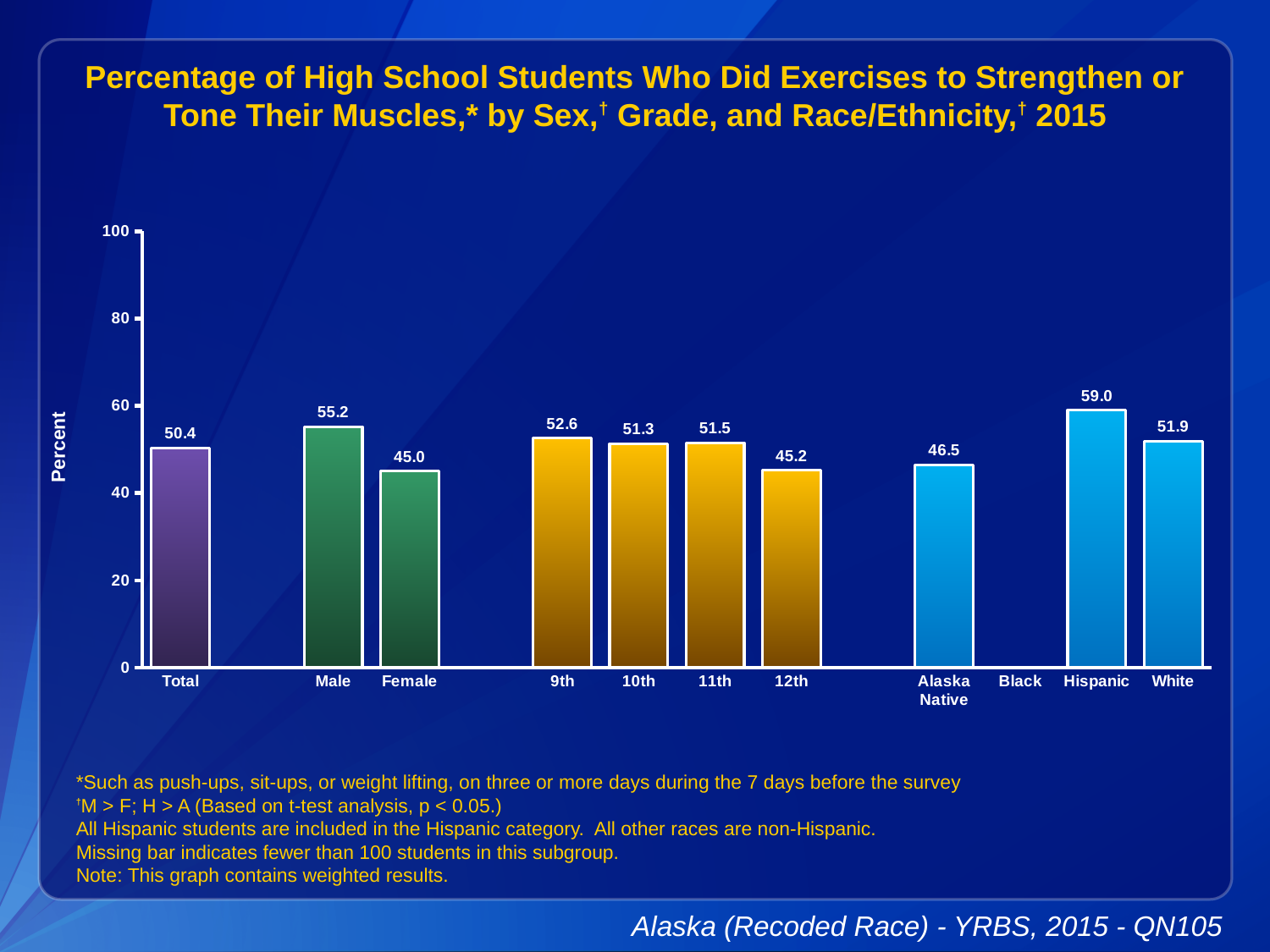
Is the value for Alaska Native greater or less than 40? greater What is the label on the y axis? Percent Which category has the highest value? Hispanic Which category has no bar plotted? Black Which is larger, the value for 9th grade or the value for 12th grade? 9th What kind of chart is shown? bar chart What is the value for Male? 55.2 What is the difference between the Male and Female values? 10.2 What is the value for Hispanic? 59.0 What is the value for Female? 45.0 What is the value for 12th grade? 45.2 Which category has the lowest plotted value? Female